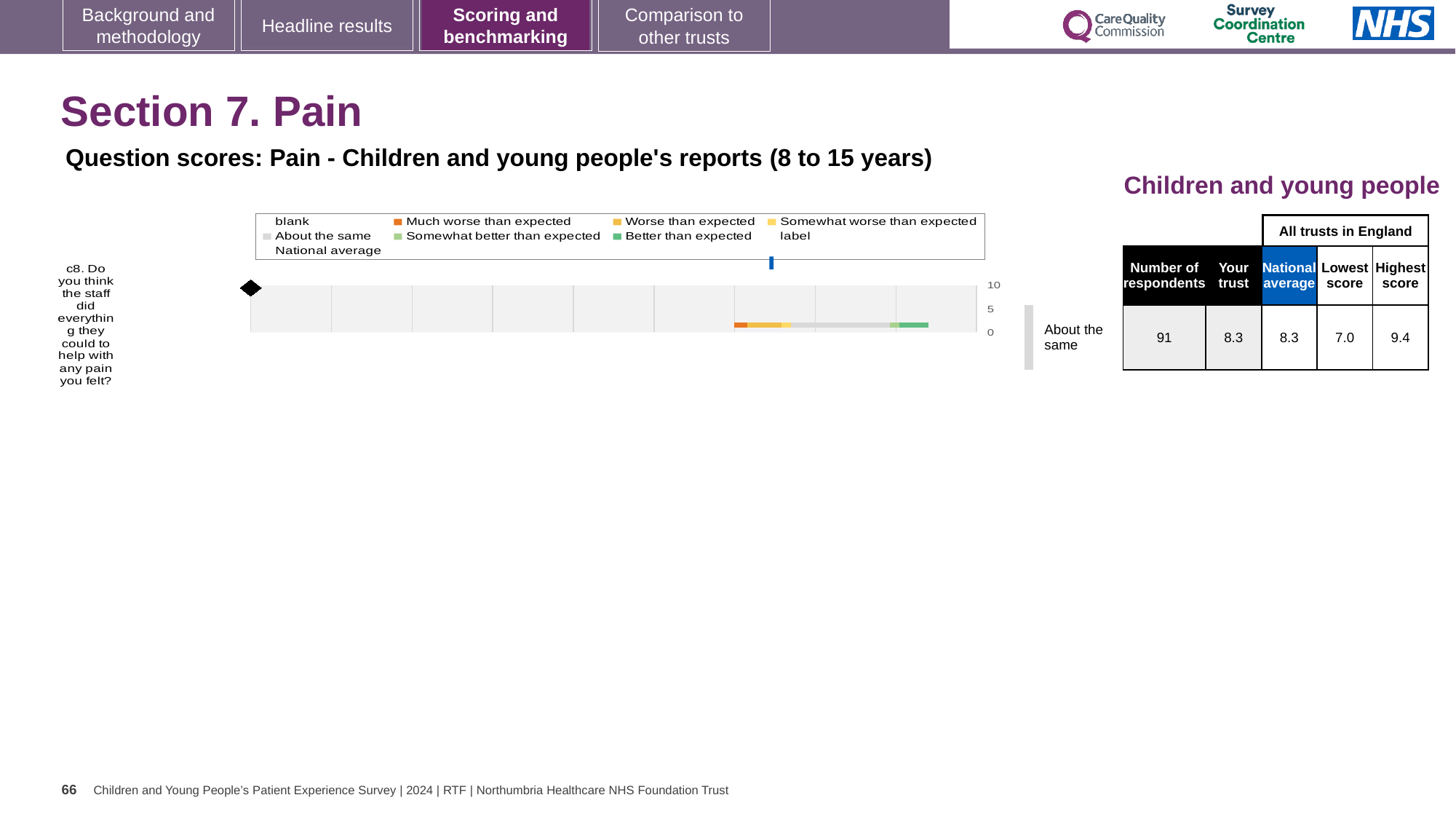
What is the difference between the national average and the lowest score for question c8? 1.3 What is the difference between the highest score and the lowest score for question c8? 2.4 What is the maximum value shown on the chart's score axis? 10 Which benchmarking category is the trust's result for question c8 placed in? About the same Is the trust's score for question c8 greater or less than 5? greater How many respondents answered question c8? 91 How many survey questions are plotted in the chart? 1 What kind of chart is shown on the slide? bar chart What is the national average score for question c8? 8.3 What is the lowest score among all trusts in England for question c8? 7.0 What is the highest score among all trusts in England for question c8? 9.4 What is the 'Your trust' score for question c8 about staff helping with pain? 8.3